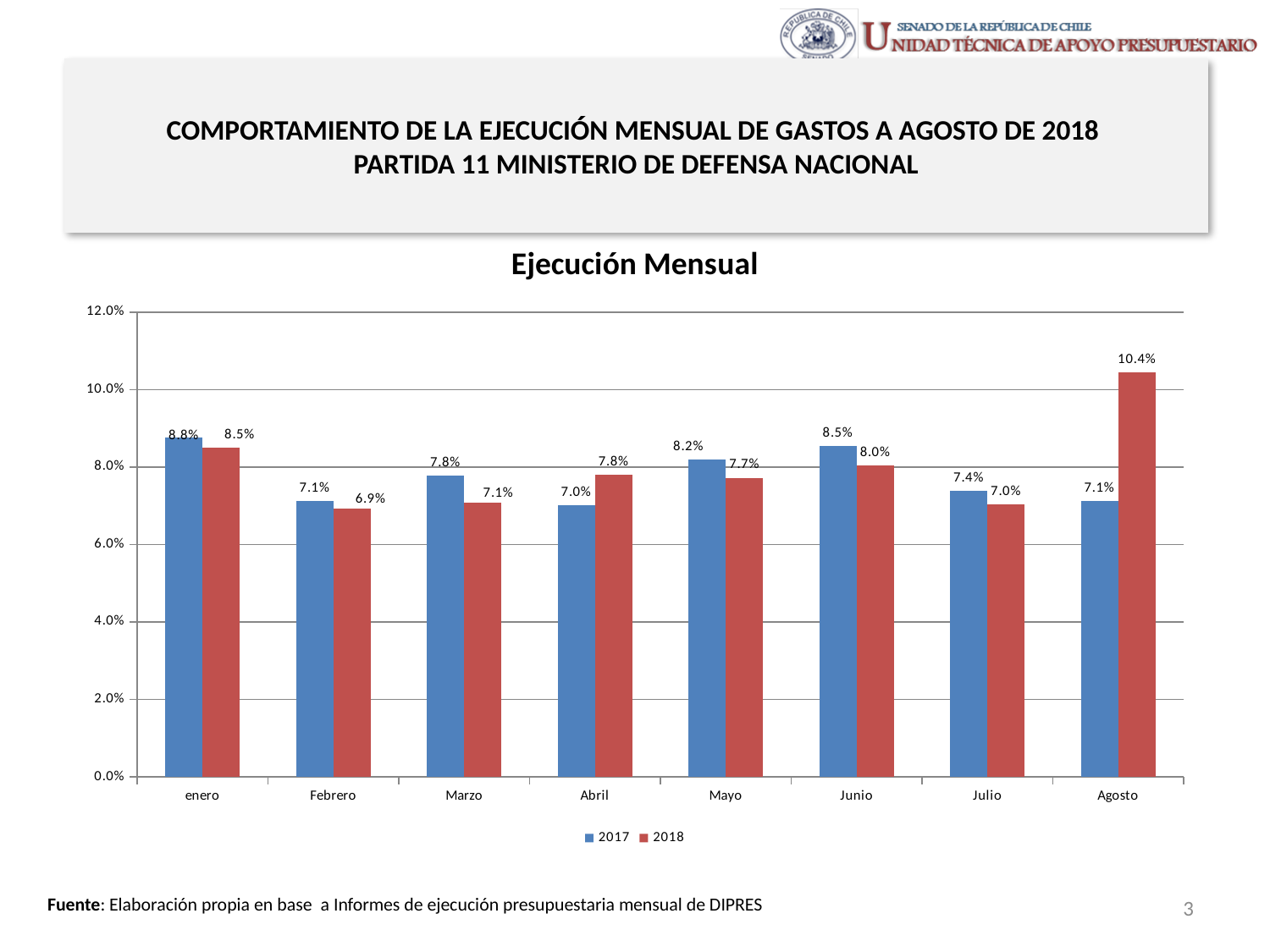
How many months are shown on the x axis? 8 How many series does the legend list? 2 What is the value for 2018 in Agosto? 10.4% Which month has the lowest value for the 2017 series? Abril What is the value for 2018 in Febrero? 6.9% What is the title of the chart? Ejecución Mensual What is the difference between the 2018 and 2017 values in Agosto? 3.3% What type of chart is shown on the slide? bar chart Which month has the highest value for the 2018 series? Agosto Is the value for 2018 in Agosto greater or less than 10.0%? greater In Abril, which series has the larger value, 2017 or 2018? 2018 What is the value for 2017 in enero? 8.8%